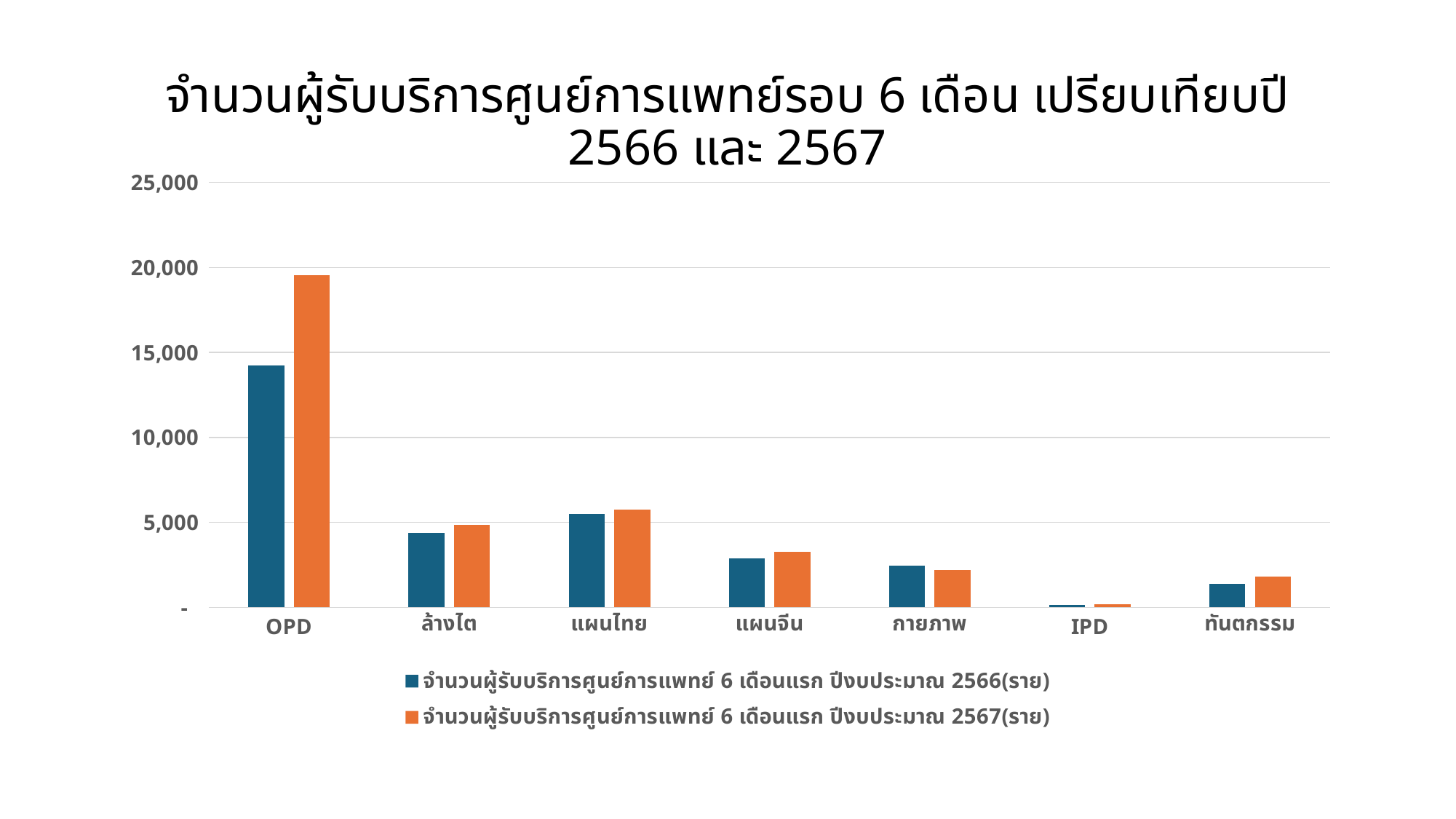
How many series does the legend list? 2 Which category has the highest value for the 2567 series? OPD For OPD, which series has the larger value, 2566 or 2567? 2567 Is the value for ล้างไต in the 2566 series greater or less than 5,000? less Is the value for OPD in the 2567 series greater or less than 15,000? greater What colour represents the 2567 series in the chart? orange Which category has the lowest value for the 2566 series? IPD What kind of chart is shown on the slide? bar chart How many categories are shown on the x axis of the chart? 7 Is the value for OPD in the 2566 series greater or less than 15,000? less For กายภาพ, which series has the larger value, 2566 or 2567? 2566